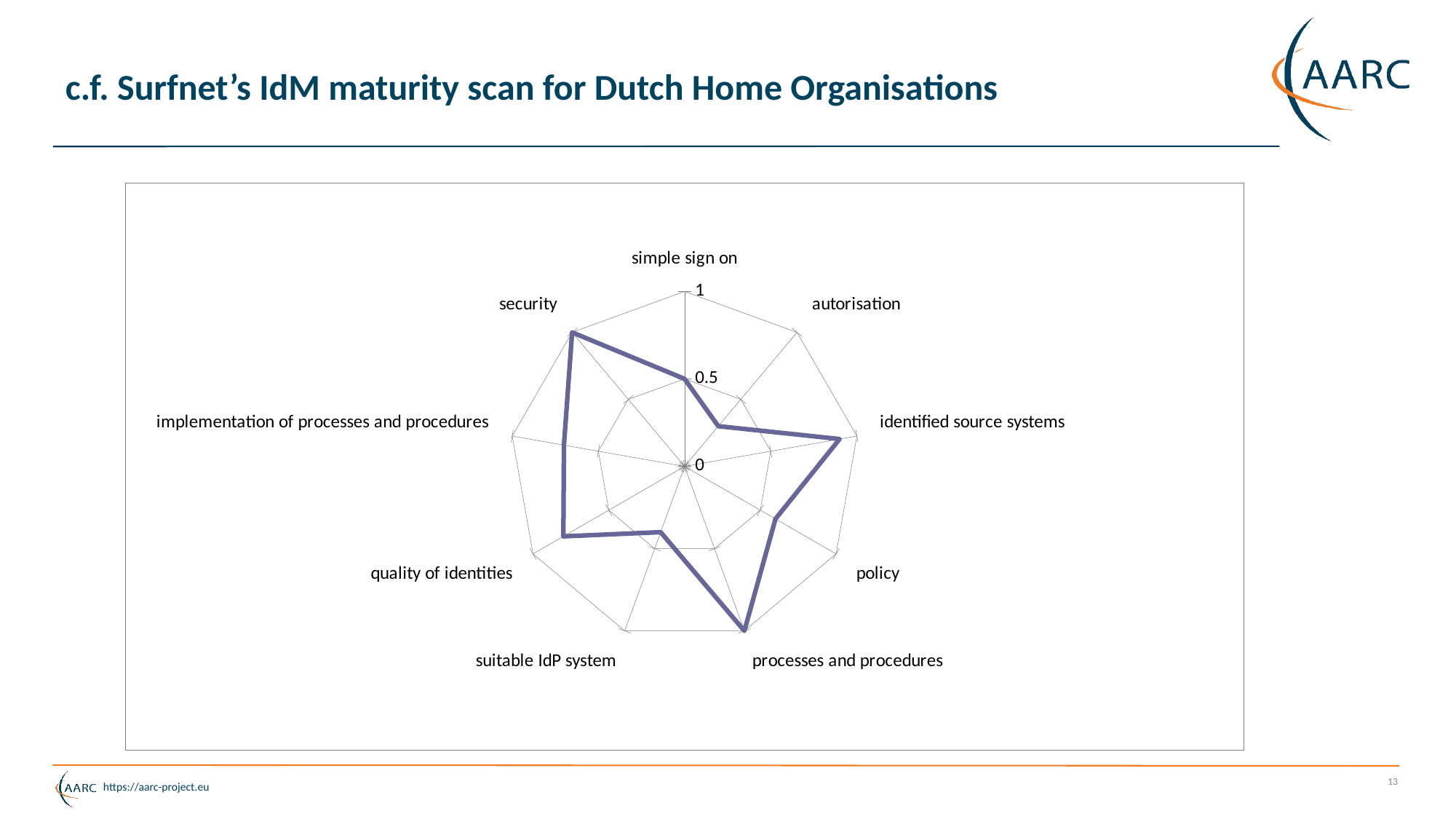
How many categories (axes) does the radar chart have? 9 Which category has the lowest value on the radar chart? autorisation What is the maximum value shown on the radar chart's axis scale? 1 Is the value for processes and procedures greater or less than 0.5? greater Is the value for security greater or less than 0.5? greater Is the value for autorisation greater or less than 0.5? less Which has the larger value, security or suitable IdP system? security Which has the larger value, identified source systems or autorisation? identified source systems What kind of chart is shown on the slide? radar chart